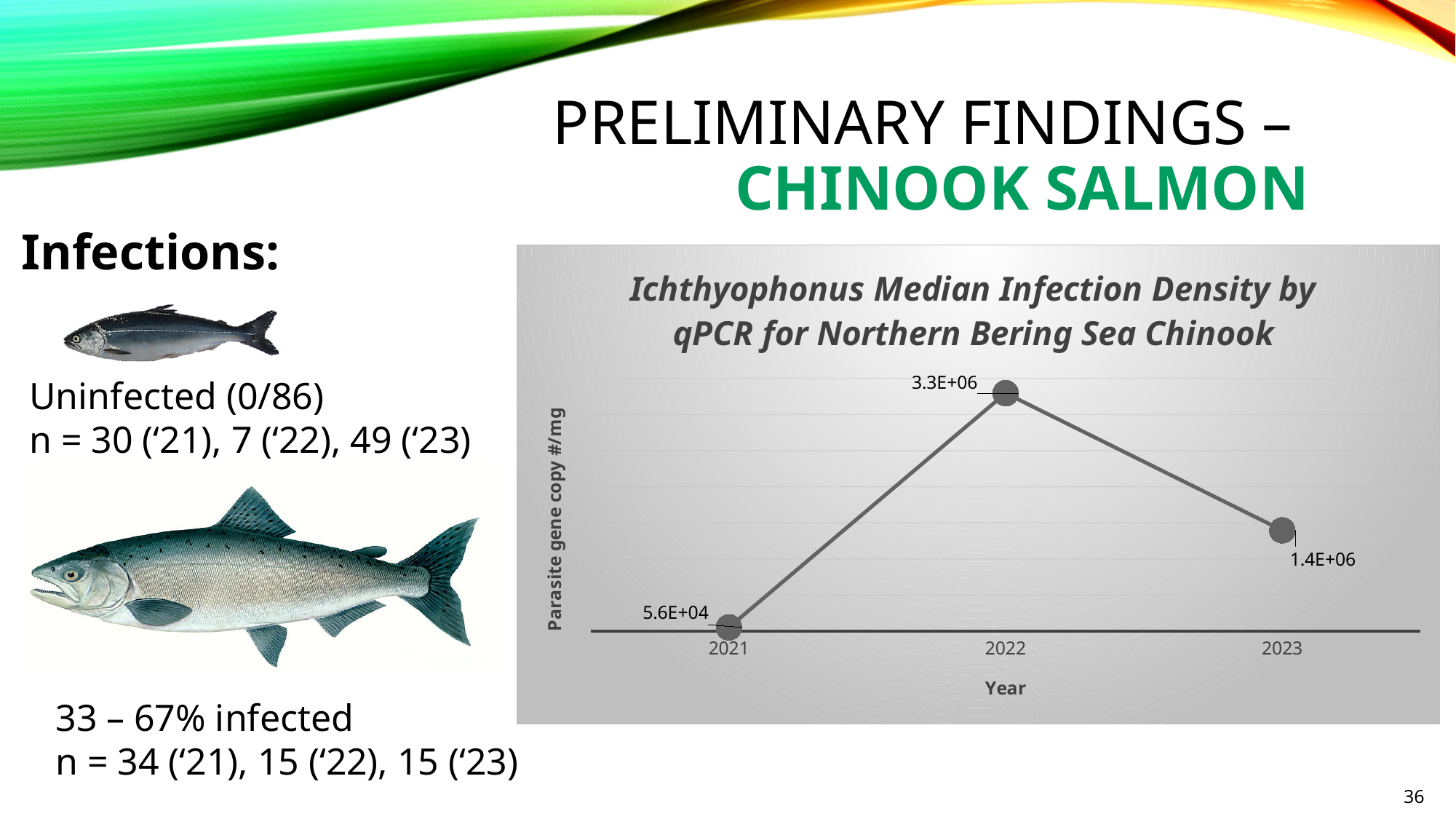
Is the median infection density higher in 2022 or in 2023? 2022 What is the difference between the 2022 and 2023 median infection density values? 1.9E+06 Which year has the highest median infection density? 2022 Which year has the lowest median infection density? 2021 Does the median infection density rise or fall from 2022 to 2023? Fall How many years are plotted on the chart? 3 What is the label of the horizontal axis of the chart? Year What is the label of the vertical axis of the chart? Parasite gene copy #/mg What is the median infection density value shown for 2021? 5.6E+04 What is the median infection density value shown for 2022? 3.3E+06 What is the median infection density value shown for 2023? 1.4E+06 What kind of chart is shown on the slide? Line chart